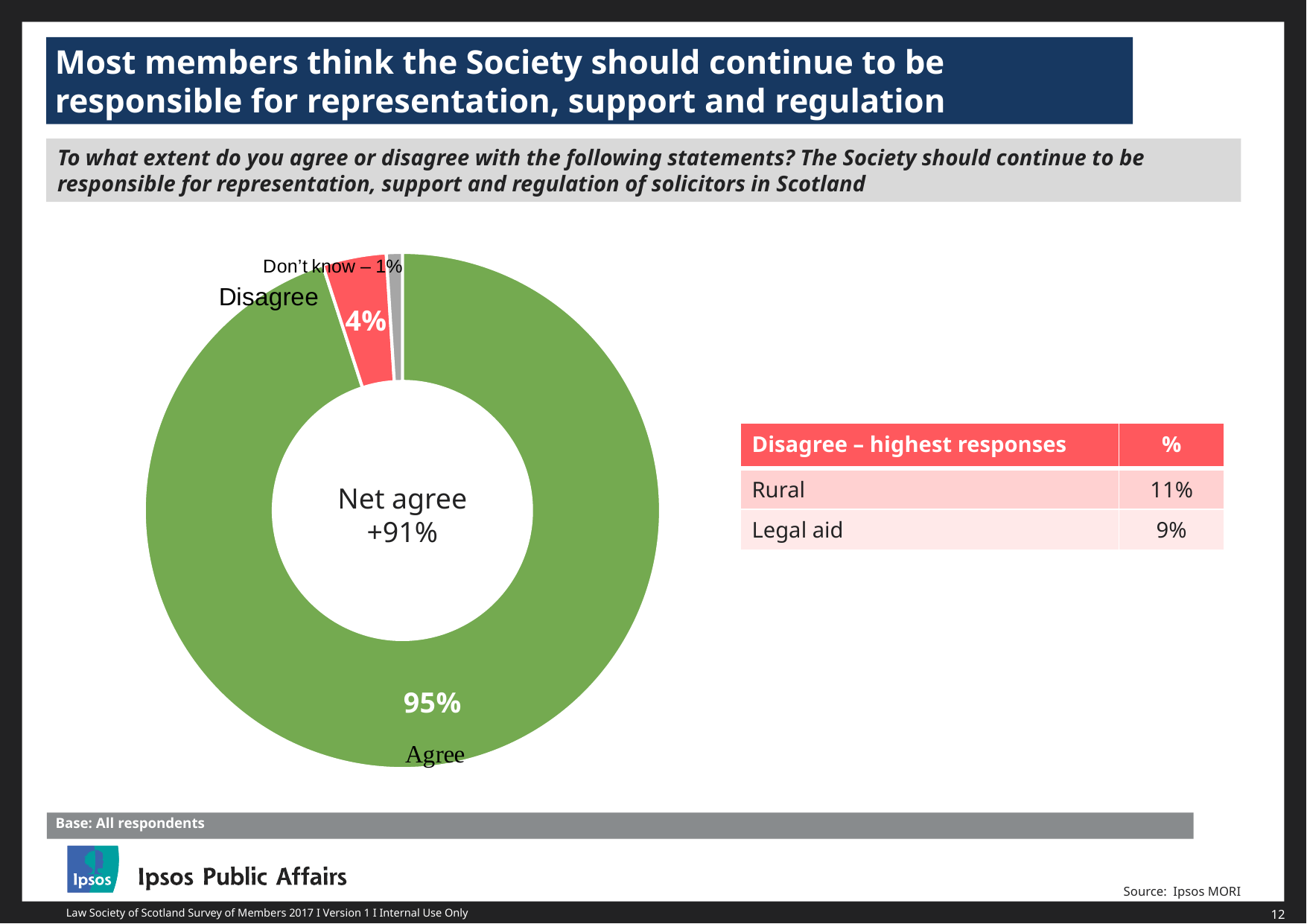
Which is larger, the Disagree share or the Don't know share? Disagree What is the net agree figure shown in the centre of the chart? +91% Which response category has the largest share of the chart? Agree What kind of chart is shown on the slide? Doughnut (pie) chart What colour is the Agree segment of the chart? Green Which response category has the smallest share of the chart? Don't know How many response categories are shown in the chart? 3 What percentage of respondents answered 'Don't know'? 1% What percentage of respondents disagree? 4% What percentage of respondents agree that the Society should continue to be responsible for representation, support and regulation? 95% In the 'Disagree – highest responses' table, what percentage is shown for Rural? 11% What is the difference in percentage points between Agree and Disagree? 91 percentage points